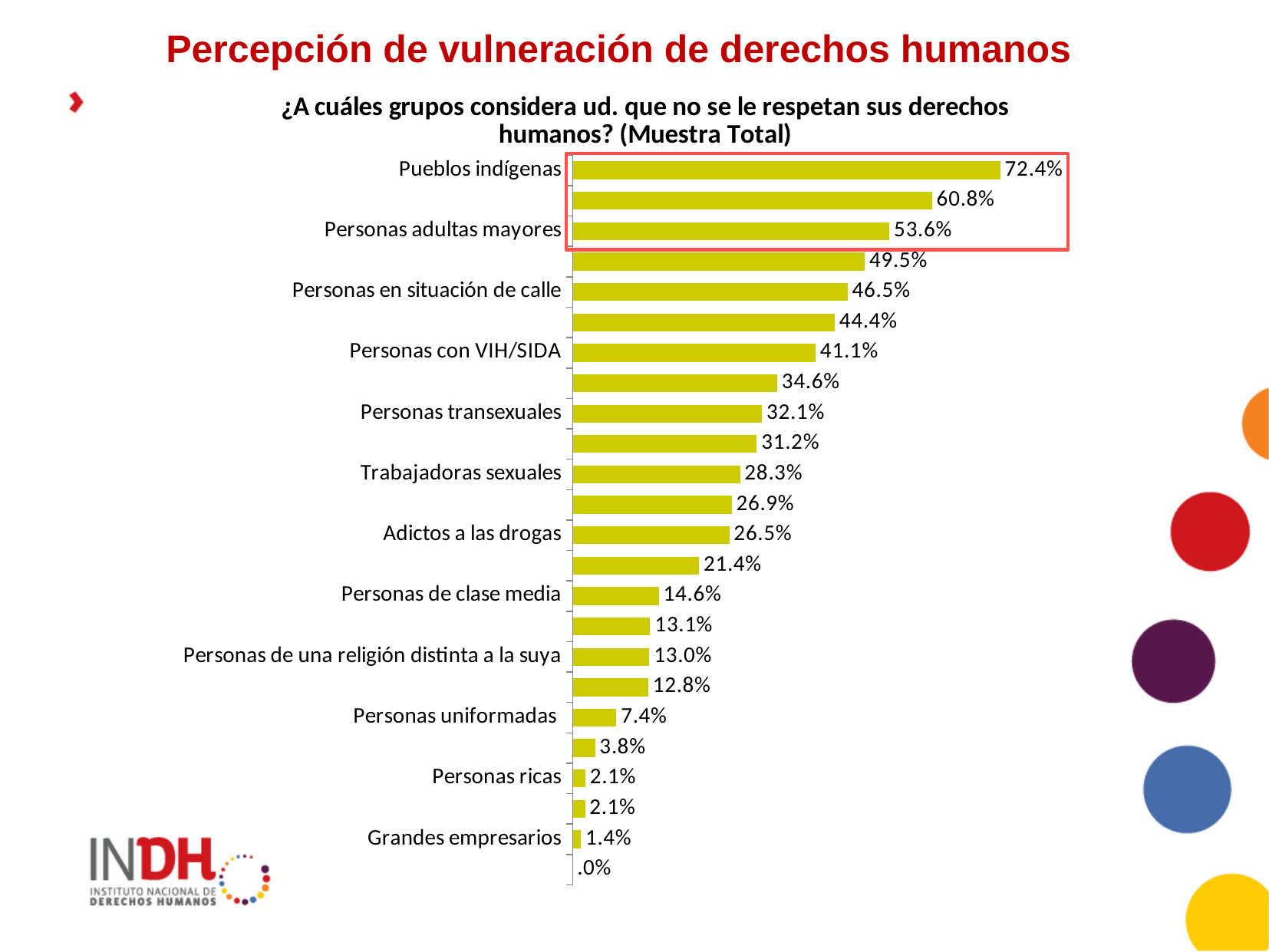
What kind of chart is shown on the slide? Bar chart Which group has the highest percentage in the chart? Pueblos indígenas What percentage is shown for Personas uniformadas? 7.4% What is the highest percentage value shown in the chart? 72.4% What percentage is shown for Personas adultas mayores? 53.6% Which has a higher percentage, Personas transexuales or Trabajadoras sexuales? Personas transexuales What percentage is shown for Grandes empresarios? 1.4% How many bars are enclosed by the red box at the top of the chart? 3 How many bars are plotted in the chart? 23 What is the difference in percentage points between Pueblos indígenas and Personas adultas mayores? 18.8 What percentage is shown for Personas con VIH/SIDA? 41.1% What percentage is shown for Pueblos indígenas? 72.4%